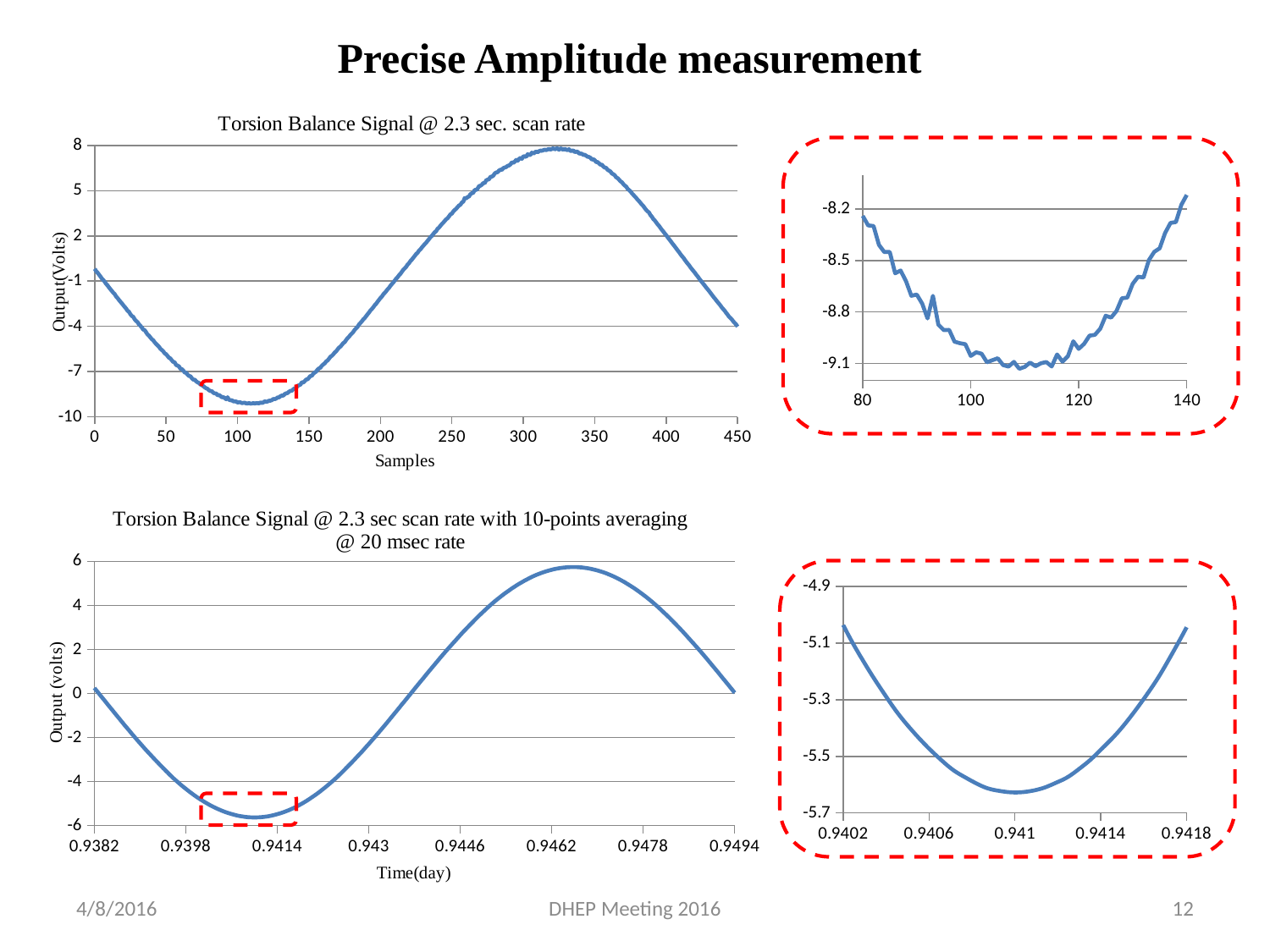
In the top-left chart 'Torsion Balance Signal @ 2.3 sec. scan rate', is the value at sample 300 greater or less than 5? greater In the top-left chart 'Torsion Balance Signal @ 2.3 sec. scan rate', what is the x-axis title? Samples In the bottom-right zoomed inset chart (x axis 0.9402 to 0.9418), is the value at 0.941 greater or less than -5.5? less What kind of chart is the top-left chart titled 'Torsion Balance Signal @ 2.3 sec. scan rate'? line chart In the top-left chart 'Torsion Balance Signal @ 2.3 sec. scan rate', is the value at sample 100 greater or less than -7? less In the bottom-left chart with 10-points averaging, what is the x-axis title? Time(day) In the top-left chart 'Torsion Balance Signal @ 2.3 sec. scan rate', does the signal rise or fall between sample 150 and sample 300? rise In the top-left chart 'Torsion Balance Signal @ 2.3 sec. scan rate', does the signal rise or fall between sample 0 and sample 100? fall